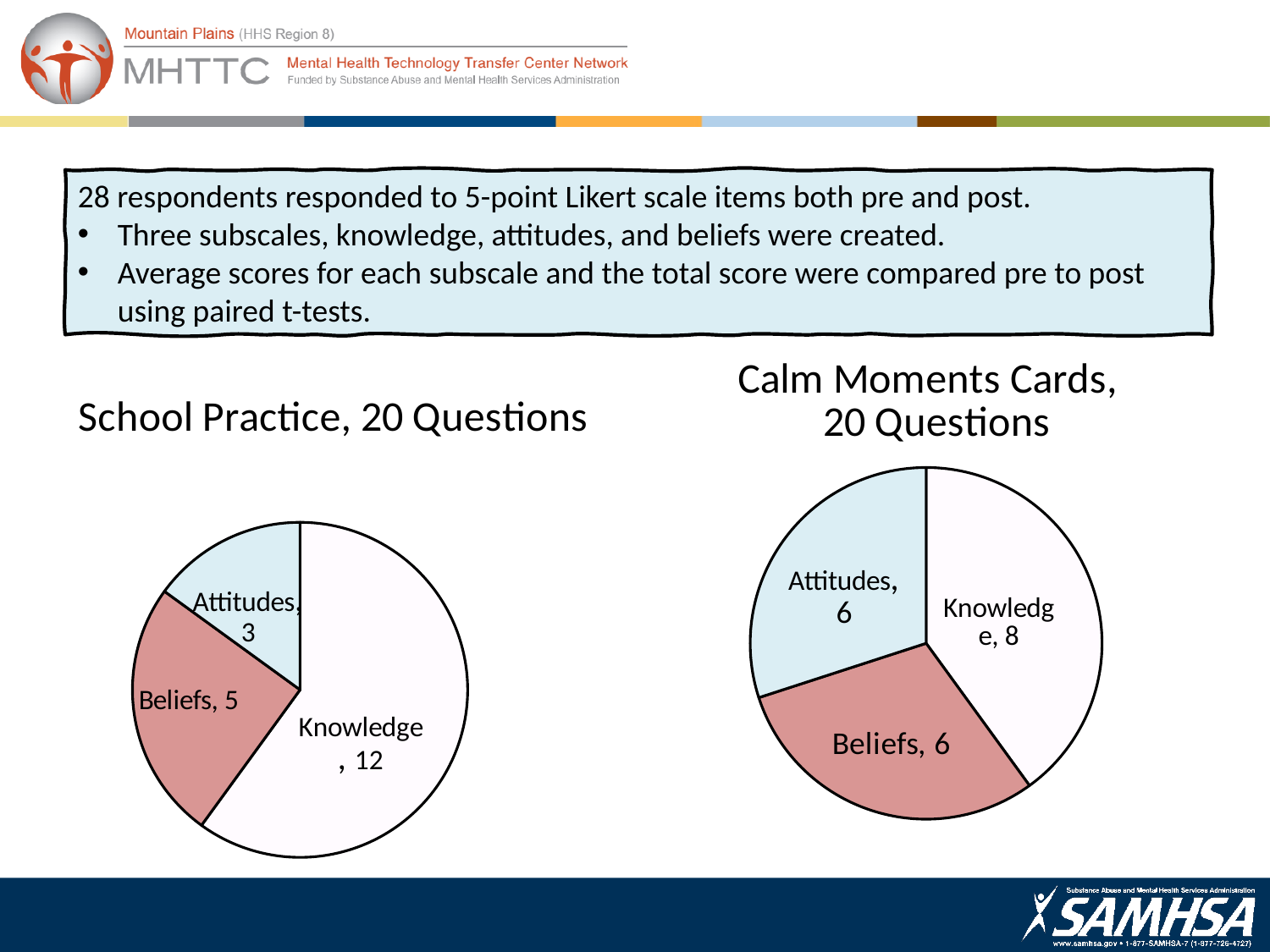
In the School Practice, 20 Questions chart, which subscale has the most questions? Knowledge In the Calm Moments Cards, 20 Questions chart, which subscale has the most questions? Knowledge In the Calm Moments Cards, 20 Questions chart, how many questions are in the Knowledge subscale? 8 In the Calm Moments Cards, 20 Questions chart, how many questions are in the Attitudes subscale? 6 What type of chart is the School Practice, 20 Questions chart? Pie chart In the School Practice, 20 Questions chart, what share of the questions does the Knowledge slice represent? 60% How many slices does the Calm Moments Cards, 20 Questions chart have? 3 In the Calm Moments Cards, 20 Questions chart, which has more questions, Knowledge or Beliefs? Knowledge In the School Practice, 20 Questions chart, what is the difference between the Knowledge and Beliefs question counts? 7 In the School Practice, 20 Questions chart, which subscale has the fewest questions? Attitudes In the School Practice, 20 Questions chart, how many questions are in the Knowledge subscale? 12 In the School Practice, 20 Questions chart, how many questions are in the Beliefs subscale? 5